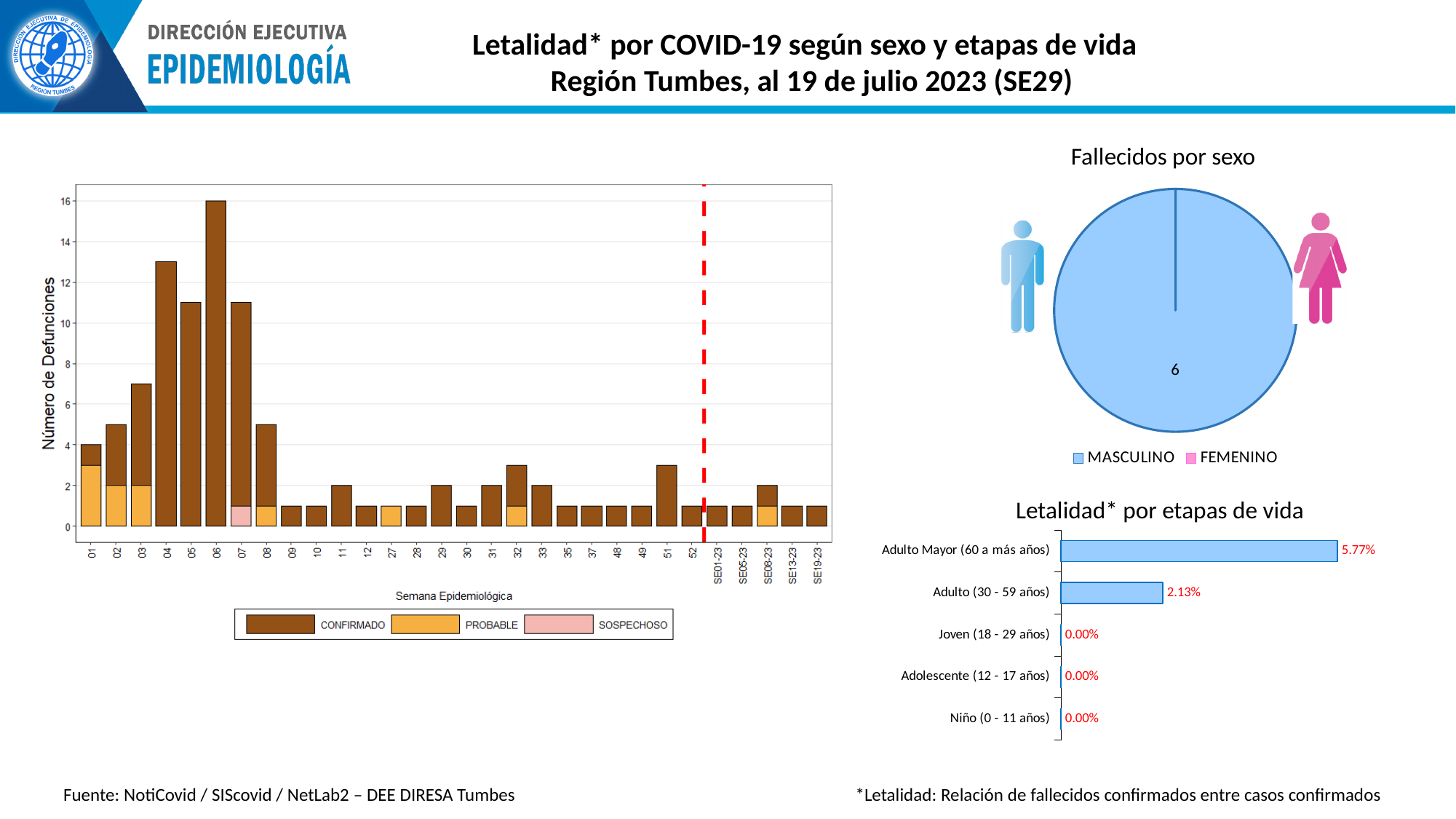
What kind of chart is 'Fallecidos por sexo'? Pie chart In the 'Letalidad* por etapas de vida' chart, what is the value for Joven (18 - 29 años)? 0.00% In the bar chart on the left, is the total for week 04 greater or less than 12? greater In the bar chart on the left, which epidemiological week has the highest number of deaths? 06 In the bar chart on the left, how many series does the legend list? 3 In the 'Letalidad* por etapas de vida' chart, what is the value for Adulto Mayor (60 a más años)? 5.77% How many series does the legend of the 'Fallecidos por sexo' chart list? 2 In the 'Fallecidos por sexo' pie chart, what value is printed for MASCULINO? 6 In the 'Letalidad* por etapas de vida' chart, what is the value for Adulto (30 - 59 años)? 2.13% In the 'Letalidad* por etapas de vida' chart, which age group has the highest value? Adulto Mayor (60 a más años) In the 'Letalidad* por etapas de vida' chart, what is the difference between the values for Adulto Mayor (60 a más años) and Adulto (30 - 59 años)? 3.64% In the 'Letalidad* por etapas de vida' chart, how many age groups are shown? 5